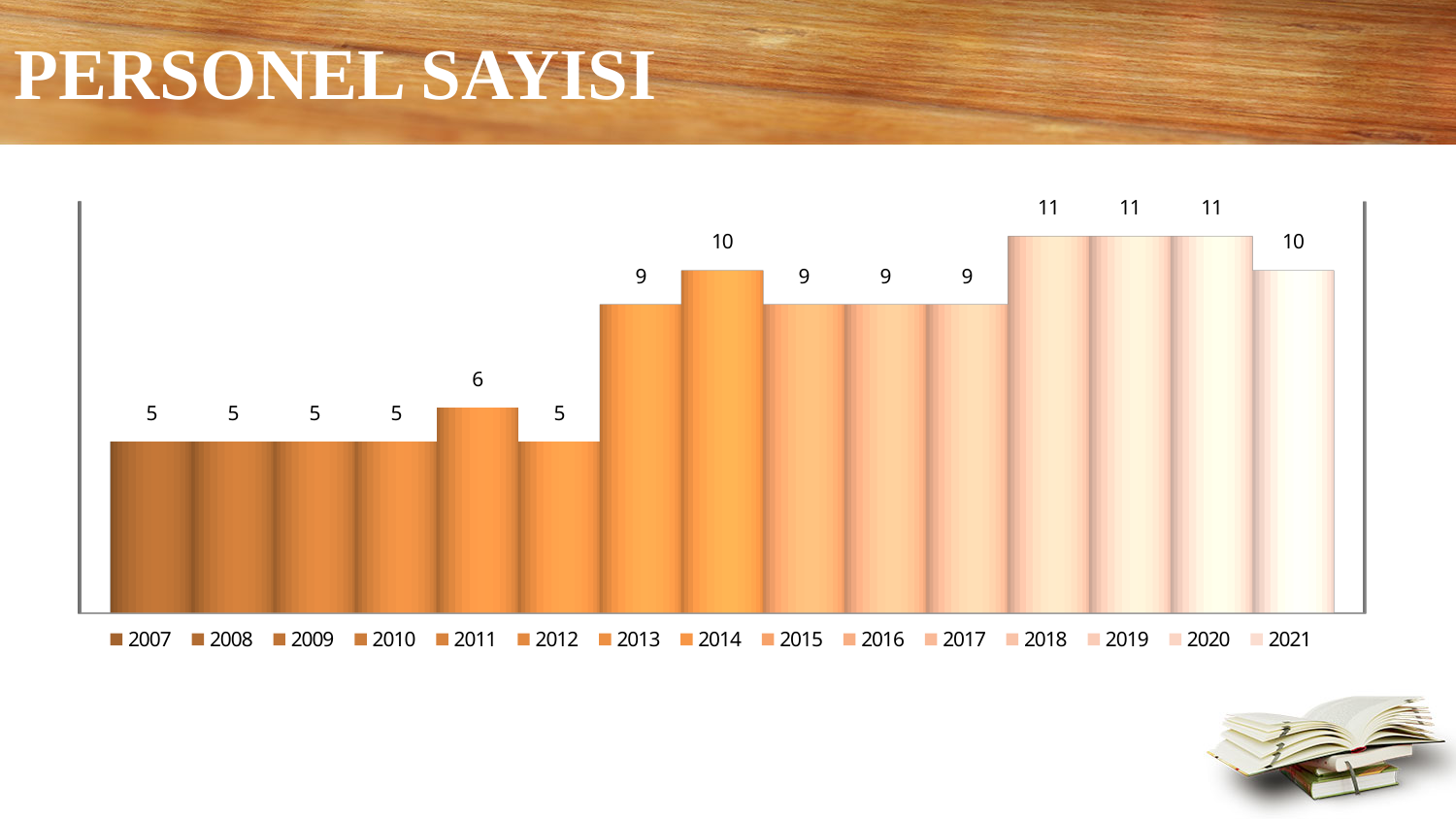
What is the lowest value shown in the chart? 5 What is the highest value shown in the chart? 11 What is the difference between the values for 2018 and 2012? 6 What is the difference between the values for 2014 and 2013? 1 What is the value for 2021? 10 Which is larger, the value for 2019 or the value for 2021? 2019 What is the value for 2014? 10 How many bars are plotted in the chart? 15 What is the value for 2007? 5 What is the value for 2011? 6 What is the title of the slide containing the chart? PERSONEL SAYISI What kind of chart is shown on the slide? Bar chart